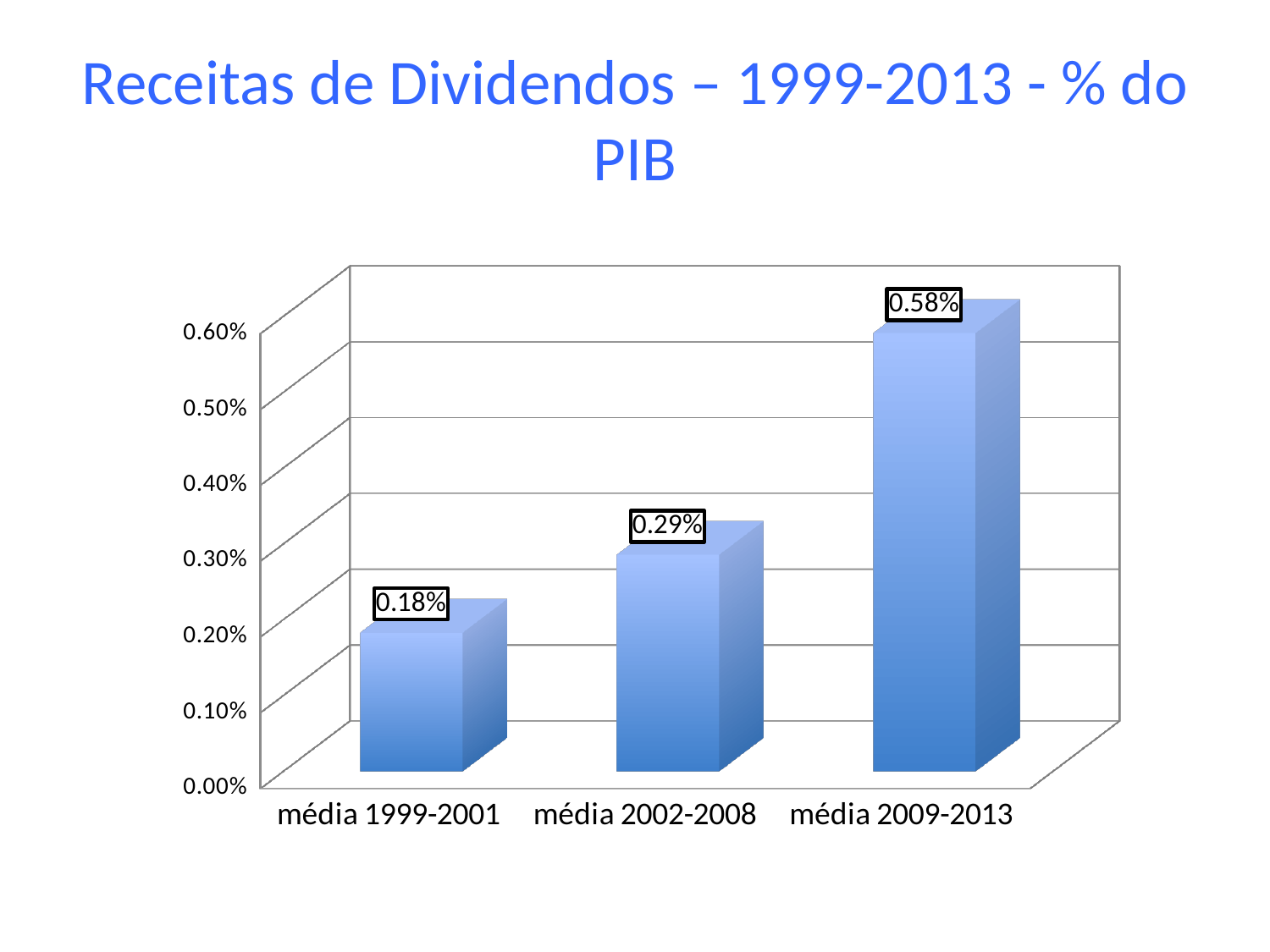
What is the value for média 2009-2013? 0.58% What is the value for média 2002-2008? 0.29% Which category has the highest value? média 2009-2013 Do the values rise or fall from left to right along the x axis? rise Is the value for média 2009-2013 greater or less than 0.50%? greater What is the difference between the values for média 2009-2013 and média 2002-2008? 0.29% What kind of chart is shown on the slide? bar chart What is the value for média 1999-2001? 0.18% How many categories are shown on the chart? 3 Which is larger, the value for média 2002-2008 or the value for média 1999-2001? média 2002-2008 Which category has the lowest value? média 1999-2001 What is the difference between the values for média 2002-2008 and média 1999-2001? 0.11%